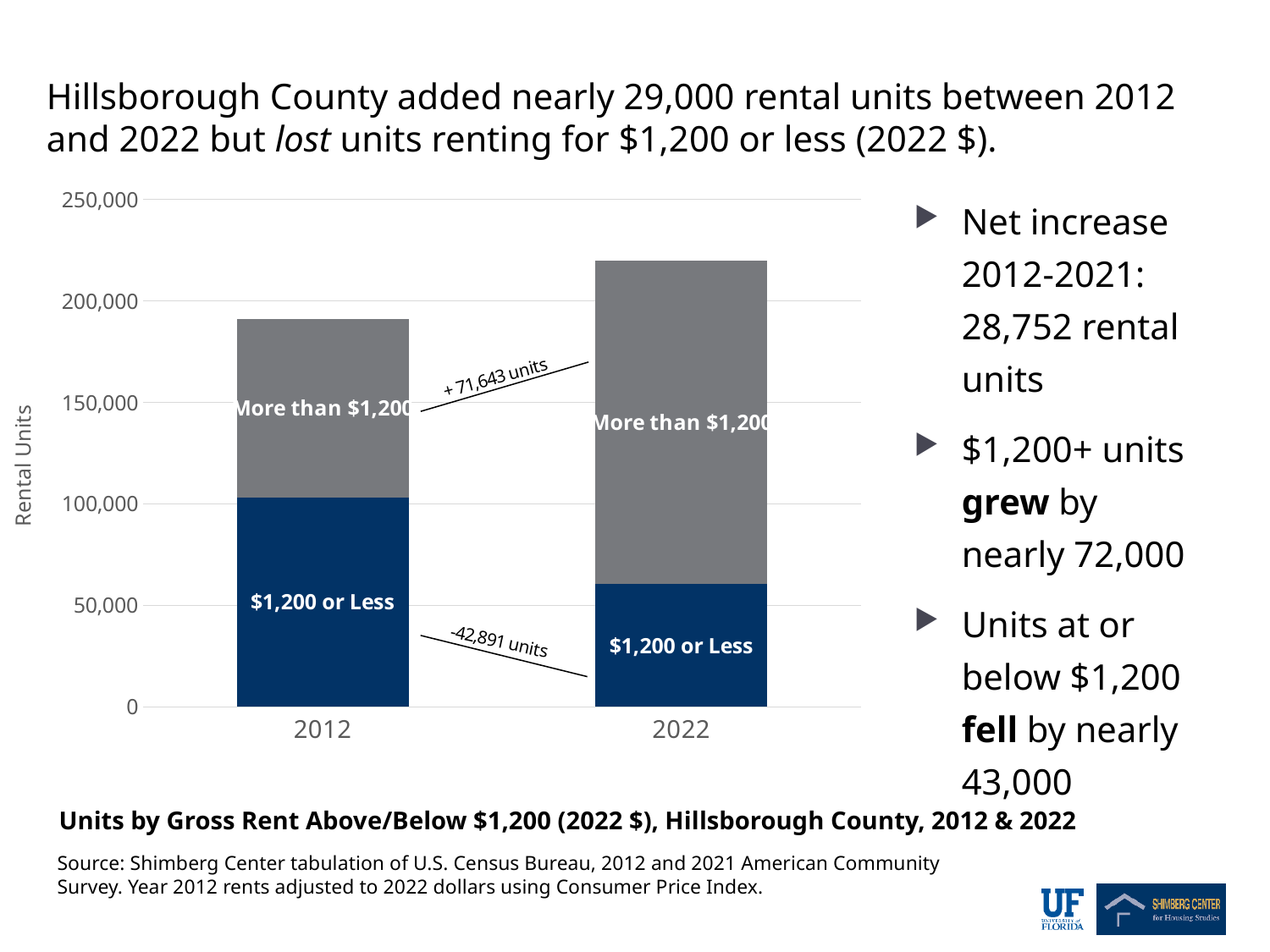
How many rent segments are stacked in each bar of the chart? 2 Which year has the taller total bar in the chart, 2012 or 2022? 2022 What kind of chart is shown on the slide? Stacked bar chart Do total rental units rise or fall from 2012 to 2022 in the chart? Rise Is the total height of the 2022 bar greater or less than 200,000? greater Which year has the larger '$1,200 or Less' segment, 2012 or 2022? 2012 Is the total height of the 2012 bar greater or less than 200,000? less What is the label on the vertical axis of the chart? Rental Units How many years (categories) are shown on the x axis of the chart? 2 Is the '$1,200 or Less' segment for 2022 greater or less than 50,000? greater According to the annotation on the chart, by how much did the number of units renting for more than $1,200 change between 2012 and 2022? +71,643 units According to the annotation on the chart, by how much did the number of units renting for $1,200 or less change between 2012 and 2022? -42,891 units